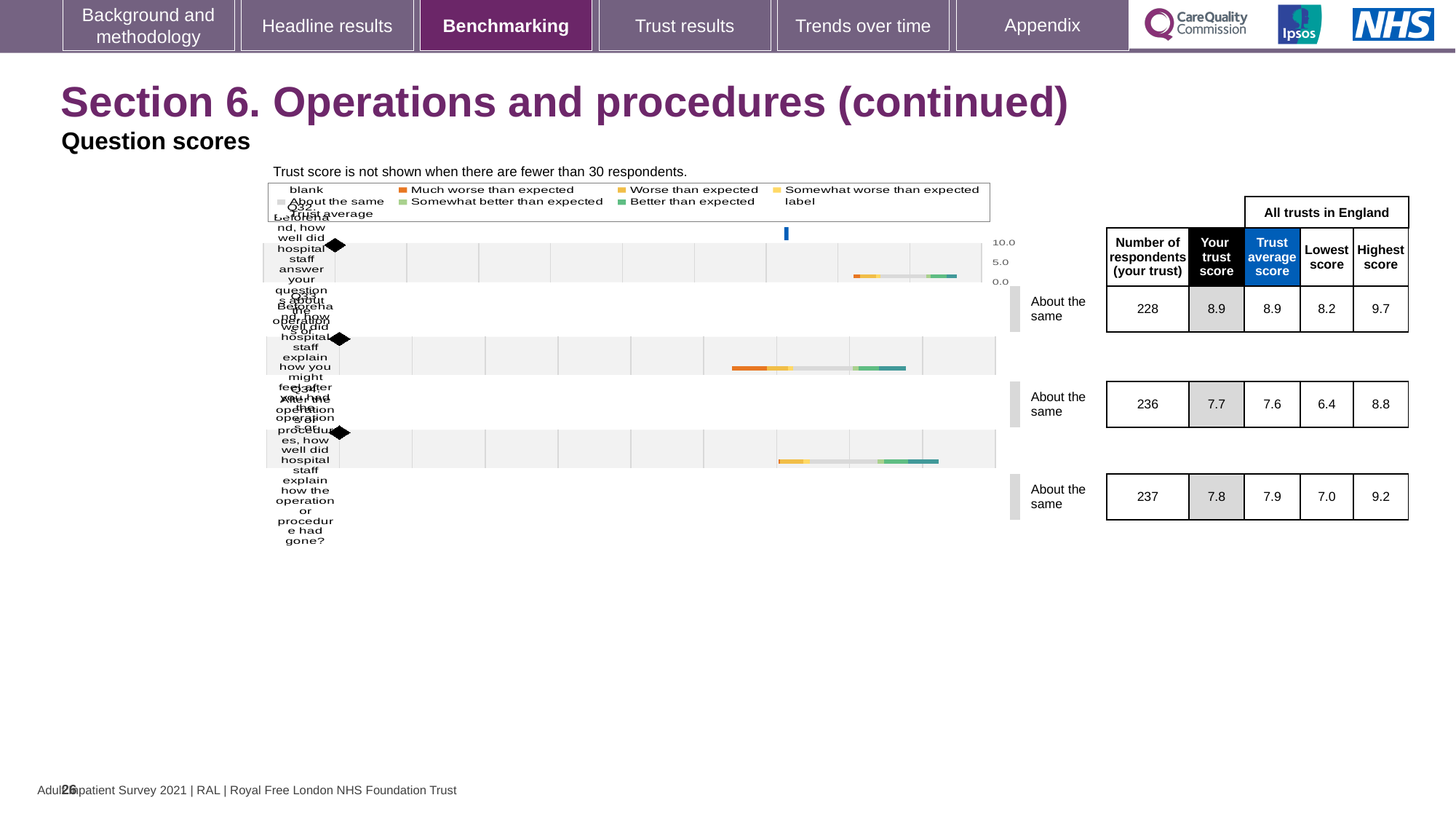
Which legend entry is shown in orange on the charts? Much worse than expected For Q33 (how well staff explained how you might feel after the operation), what is the 'Your trust score' value? 7.7 How many question charts (Q32, Q33, Q34) are shown on the slide? 3 Which of the three questions has the lowest 'Your trust score'? Q33 For Q32 (how well staff answered questions about the operation or procedure), what is the trust score shown in the 'Your trust score' column? 8.9 Is the trust score for Q32 greater or less than 5.0 on the chart axis? greater What is the difference between the 'Your trust score' for Q32 and for Q33? 1.2 Which of the three questions has the highest 'Your trust score'? Q32 What benchmark category is shown next to each of the three question charts? About the same For Q34 (how well staff explained how the operation or procedure had gone), what is the 'Your trust score' value? 7.8 What is the number of respondents for Q34? 237 What kind of chart is used to show the question scores on this slide? bar chart